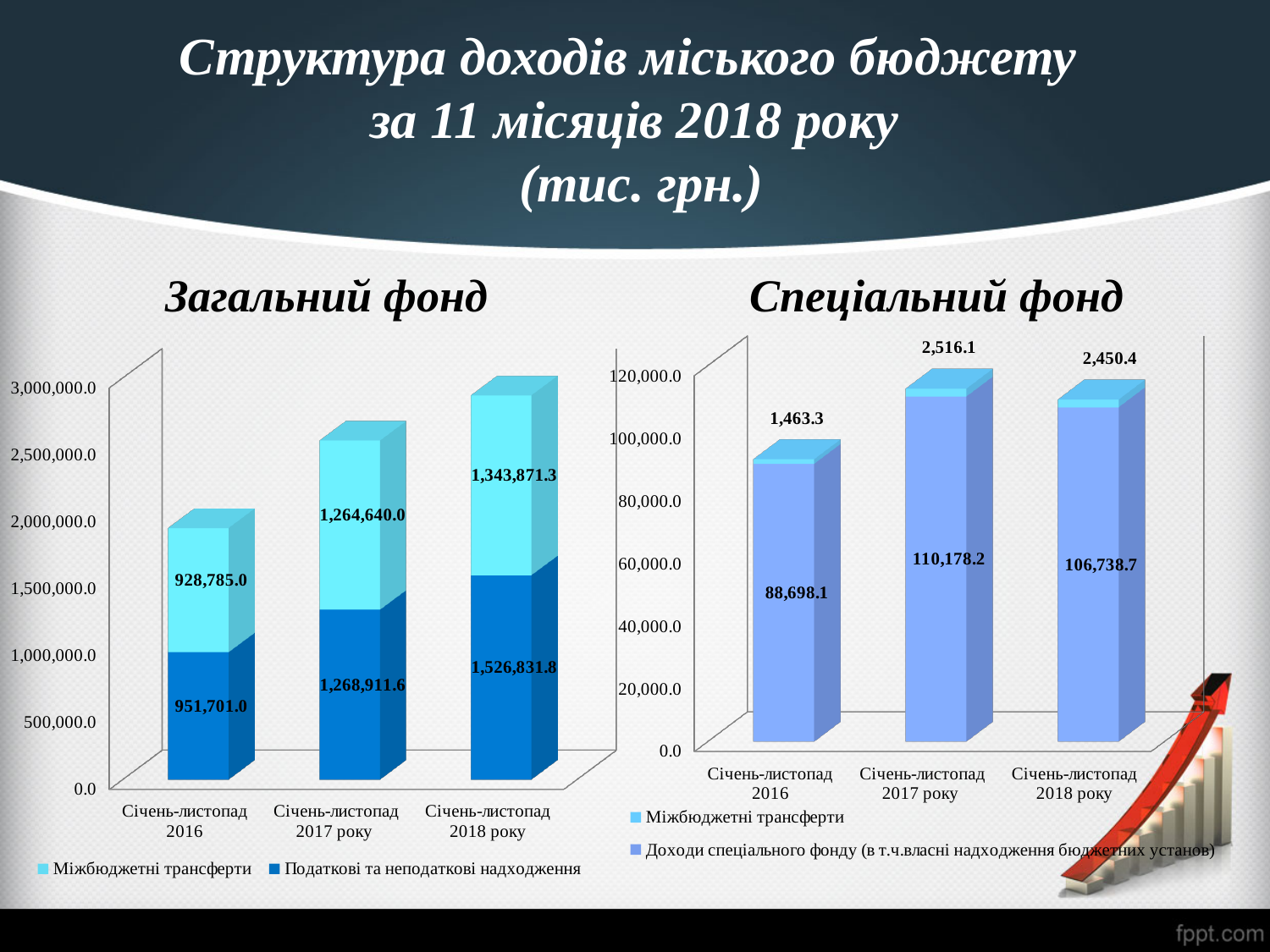
In the 'Спеціальний фонд' chart, what is the value of 'Доходи спеціального фонду' for Січень-листопад 2017 року? 110,178.2 In the 'Спеціальний фонд' chart, what is the total of the stacked bar for Січень-листопад 2017 року? 112,694.3 In the 'Спеціальний фонд' chart, what is the value of 'Міжбюджетні трансферти' for Січень-листопад 2018 року? 2,450.4 In the 'Загальний фонд' chart, what is the value of 'Податкові та неподаткові надходження' for Січень-листопад 2018 року? 1,526,831.8 In the 'Загальний фонд' chart, is 'Міжбюджетні трансферти' for Січень-листопад 2018 року larger or smaller than 'Податкові та неподаткові надходження' for the same period? smaller In the 'Загальний фонд' chart, what is the value of 'Міжбюджетні трансферти' for Січень-листопад 2016? 928,785.0 How many series does the legend of the 'Спеціальний фонд' chart list? 2 In the 'Загальний фонд' chart, what is the total of the stacked bar for Січень-листопад 2018 року? 2,870,703.1 In the 'Загальний фонд' chart, which period has the lowest value of 'Податкові та неподаткові надходження'? Січень-листопад 2016 In the 'Спеціальний фонд' chart, which period has the highest value of 'Міжбюджетні трансферти'? Січень-листопад 2017 року In the 'Загальний фонд' chart, what is the difference between 'Податкові та неподаткові надходження' for Січень-листопад 2018 року and Січень-листопад 2017 року? 257,920.2 In the 'Спеціальний фонд' chart, what is the difference between 'Доходи спеціального фонду' for Січень-листопад 2017 року and Січень-листопад 2018 року? 3,439.5